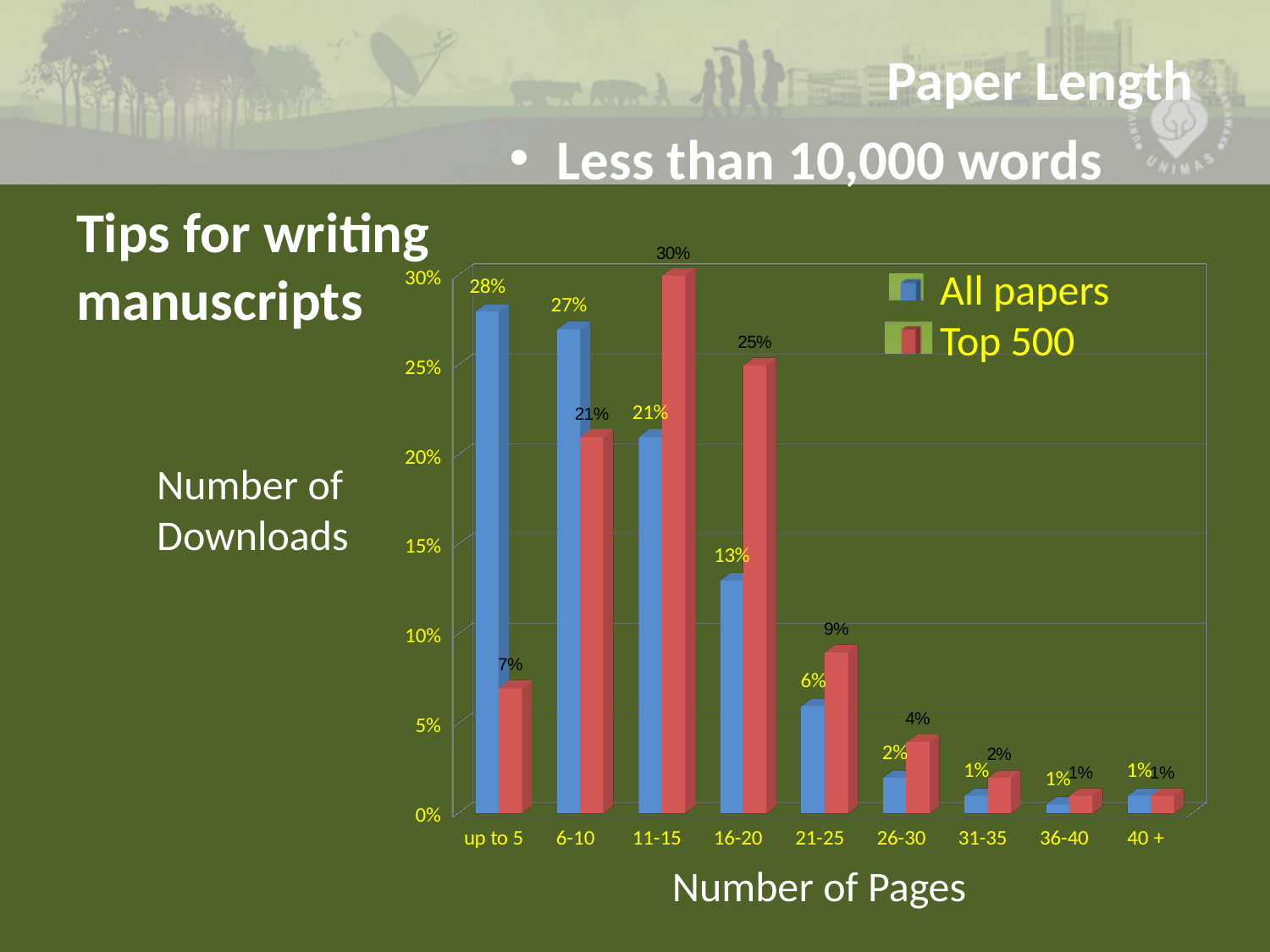
How many series does the legend list? 2 In the '16-20' category, which series has the larger value, All papers or Top 500? Top 500 Does the All papers value generally rise or fall as the number of pages increases? fall What is the value for Top 500 in the '11-15' category? 30% What is the value for Top 500 in the '16-20' category? 25% What is the label of the x axis? Number of Pages Which category has the highest value for the All papers series? up to 5 Which category has the highest value for the Top 500 series? 11-15 What kind of chart is shown on the slide? bar chart What is the value for All papers in the 'up to 5' category? 28% How many page-range categories are shown on the x axis? 9 What is the difference between All papers and Top 500 in the 'up to 5' category? 21%